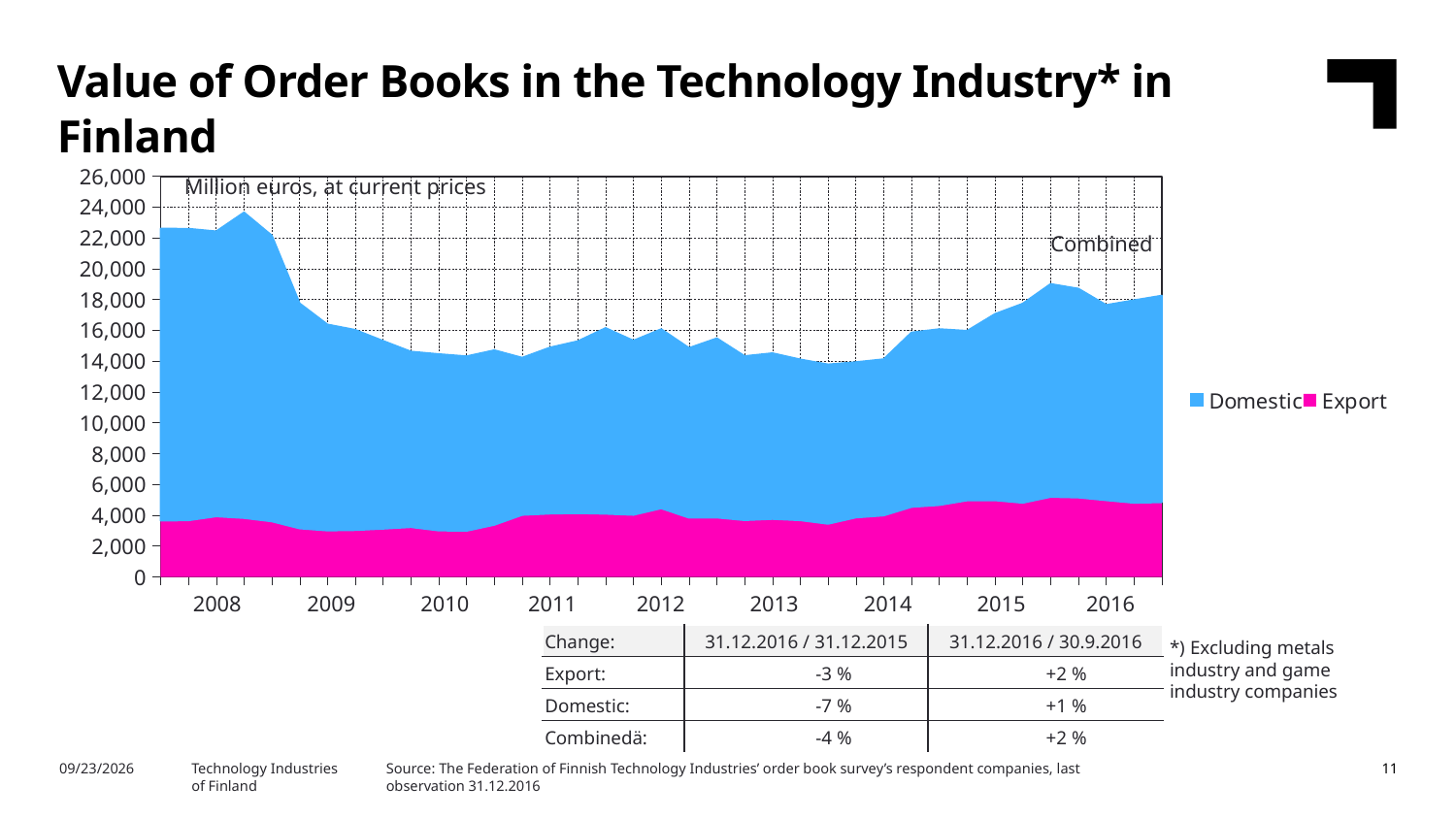
Which is larger at the end of 2016, the Domestic value or the Export value? Domestic Is the combined value of order books at the start of 2008 greater or less than 20,000? greater What kind of chart is shown on the slide? Stacked area chart In which year does the combined value of order books reach its highest level? 2008 How many series does the chart legend list? 2 Is the Export value in 2009 greater or less than 4,000? less Is the combined value of order books in 2010 greater or less than 16,000? less How many years are labelled on the x axis of the chart? 9 Which two series are listed in the chart legend? Domestic and Export What unit is stated for the values in the chart? Million euros, at current prices Does the combined value of order books rise or fall between 2008 and 2010? fall